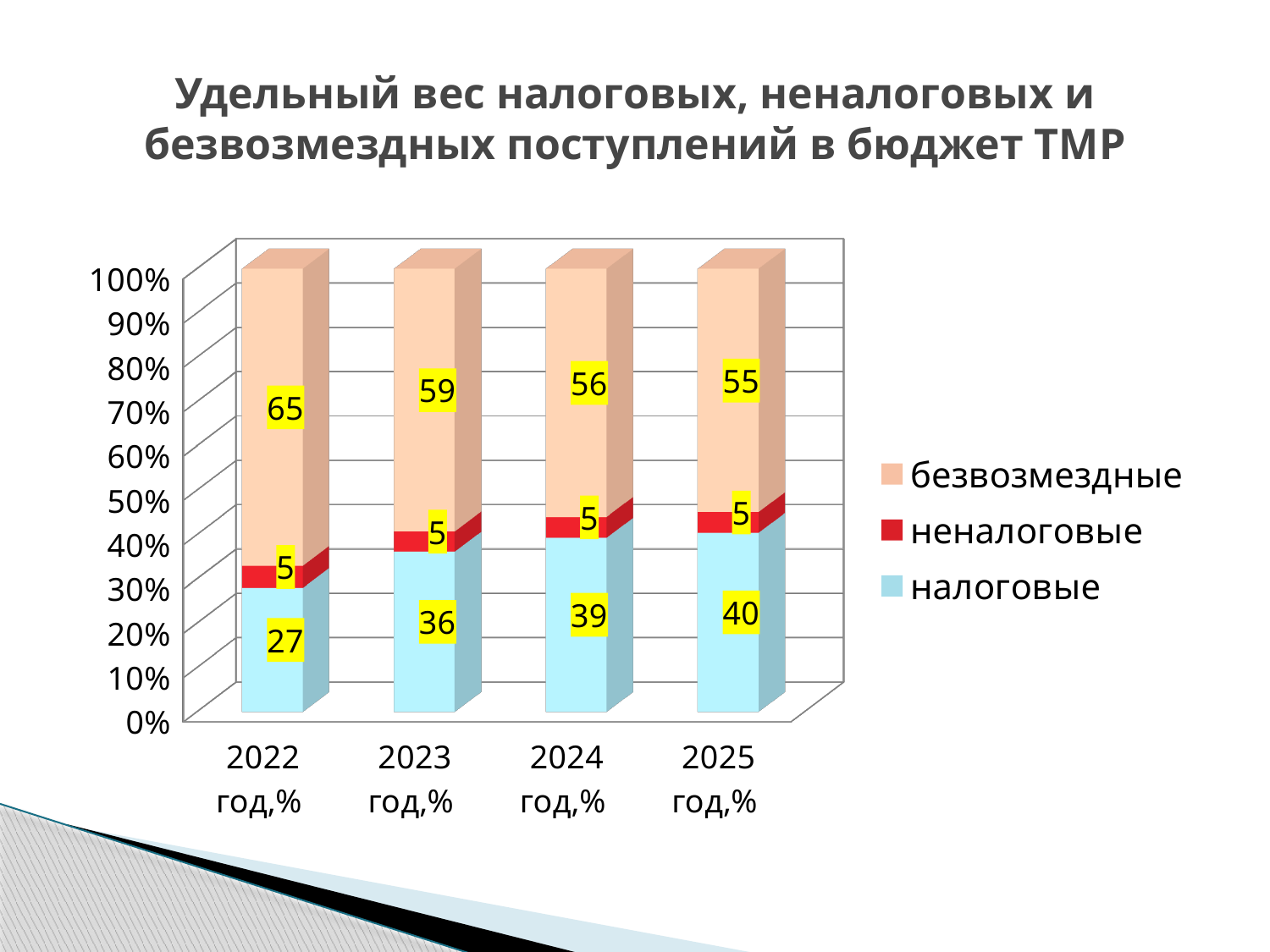
How many series does the legend list? 3 What is the value for налоговые in 2022 год,%? 27 What is the value for безвозмездные in 2025 год,%? 55 What is the total of the stacked bar for 2023 год,%? 100 In which year is the value for безвозмездные highest? 2022 год,% Do the налоговые values rise or fall from 2022 to 2025? rise In which year is the value for налоговые lowest? 2022 год,% How many years are shown on the x axis? 4 What kind of chart is shown on the slide? stacked bar chart What is the value for неналоговые in 2024 год,%? 5 Which is larger, the налоговые value for 2023 год,% or for 2024 год,%? 2024 год,% What is the difference between the безвозмездные values for 2022 год,% and 2025 год,%? 10